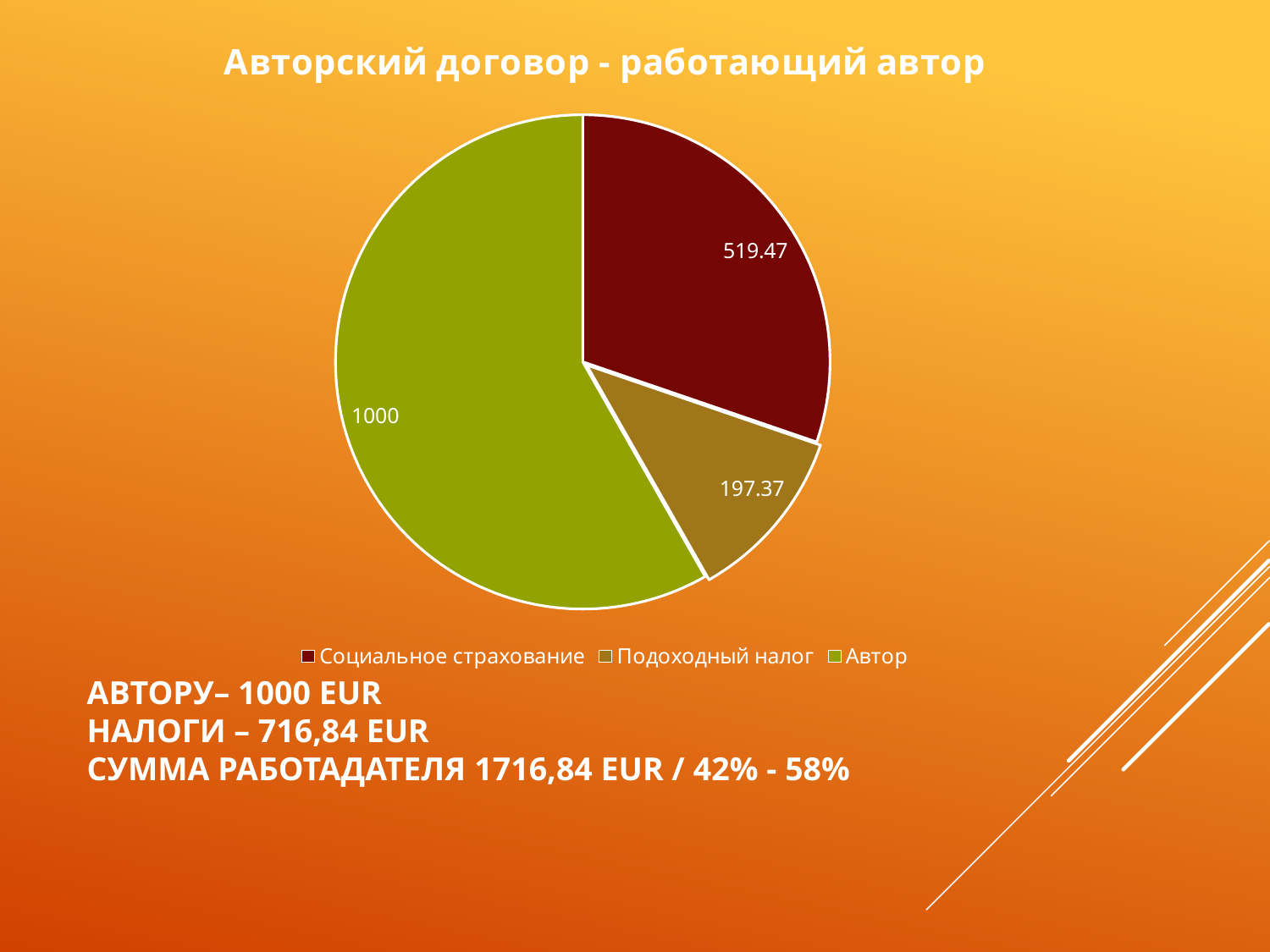
What is the value for Автор? 1000 Which legend entry is shown in green? Автор What type of chart is shown on the slide? pie chart What is the title of the chart? Авторский договор - работающий автор Which category has the smallest slice? Подоходный налог How many slices does the pie chart have? 3 What is the difference between the values for Социальное страхование and Подоходный налог? 322.10 What is the difference between the values for Автор and Социальное страхование? 480.53 What is the value for Подоходный налог? 197.37 Which category has the largest slice? Автор Which is larger, Социальное страхование or Подоходный налог? Социальное страхование What is the value for Социальное страхование? 519.47